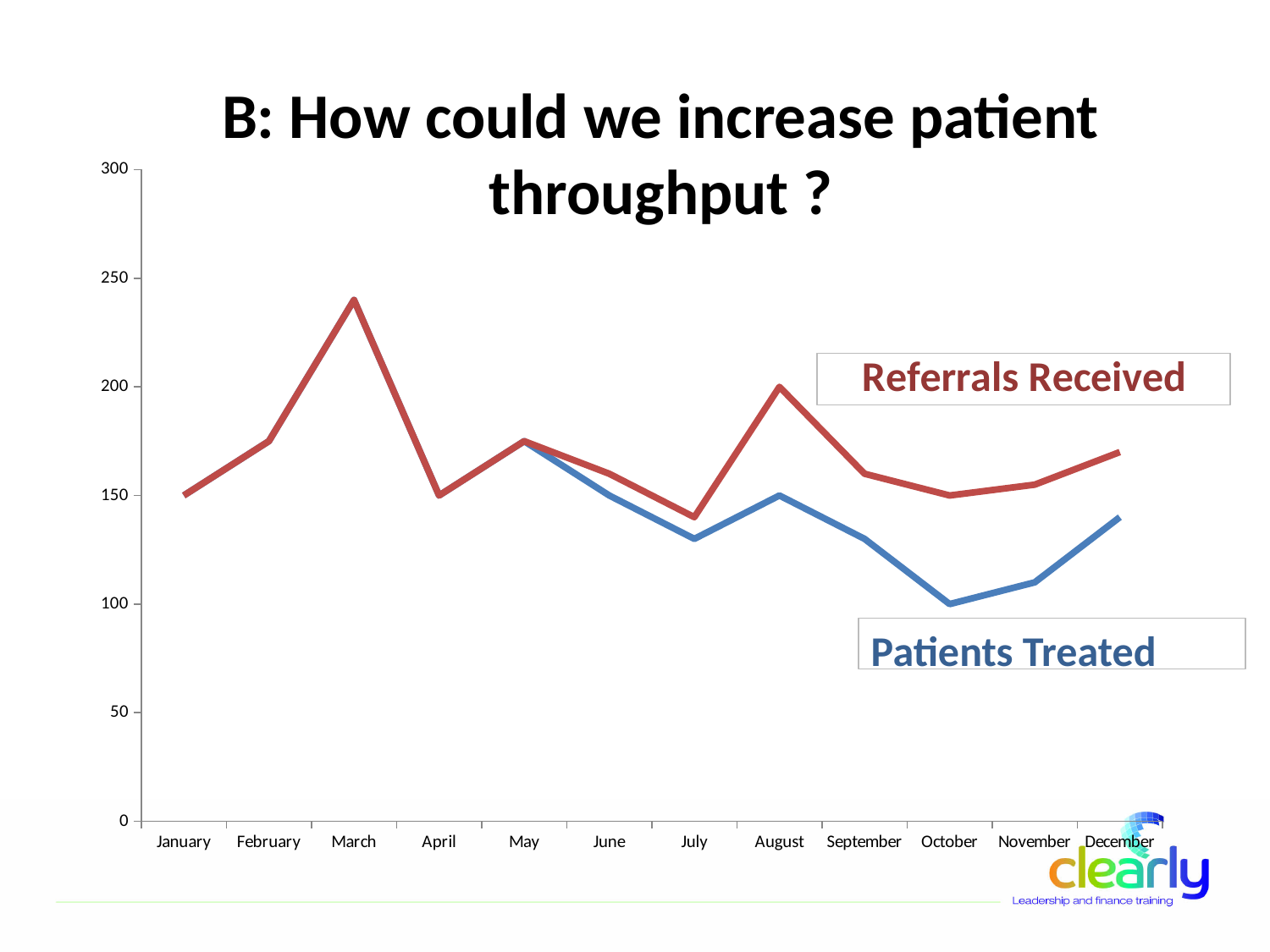
Is the value for Referrals Received in December greater or less than 150? greater Does Patients Treated rise or fall from May to October? fall Is the value for Patients Treated in July greater or less than 150? less How many months are shown along the x axis? 12 What kind of chart is shown on the slide? line chart How many series are plotted on the chart? 2 In which month is Referrals Received highest? March Which is larger in October, Referrals Received or Patients Treated? Referrals Received In which month is Patients Treated lowest? October What colour is the Referrals Received line? red Is the value for Referrals Received in March greater or less than 200? greater